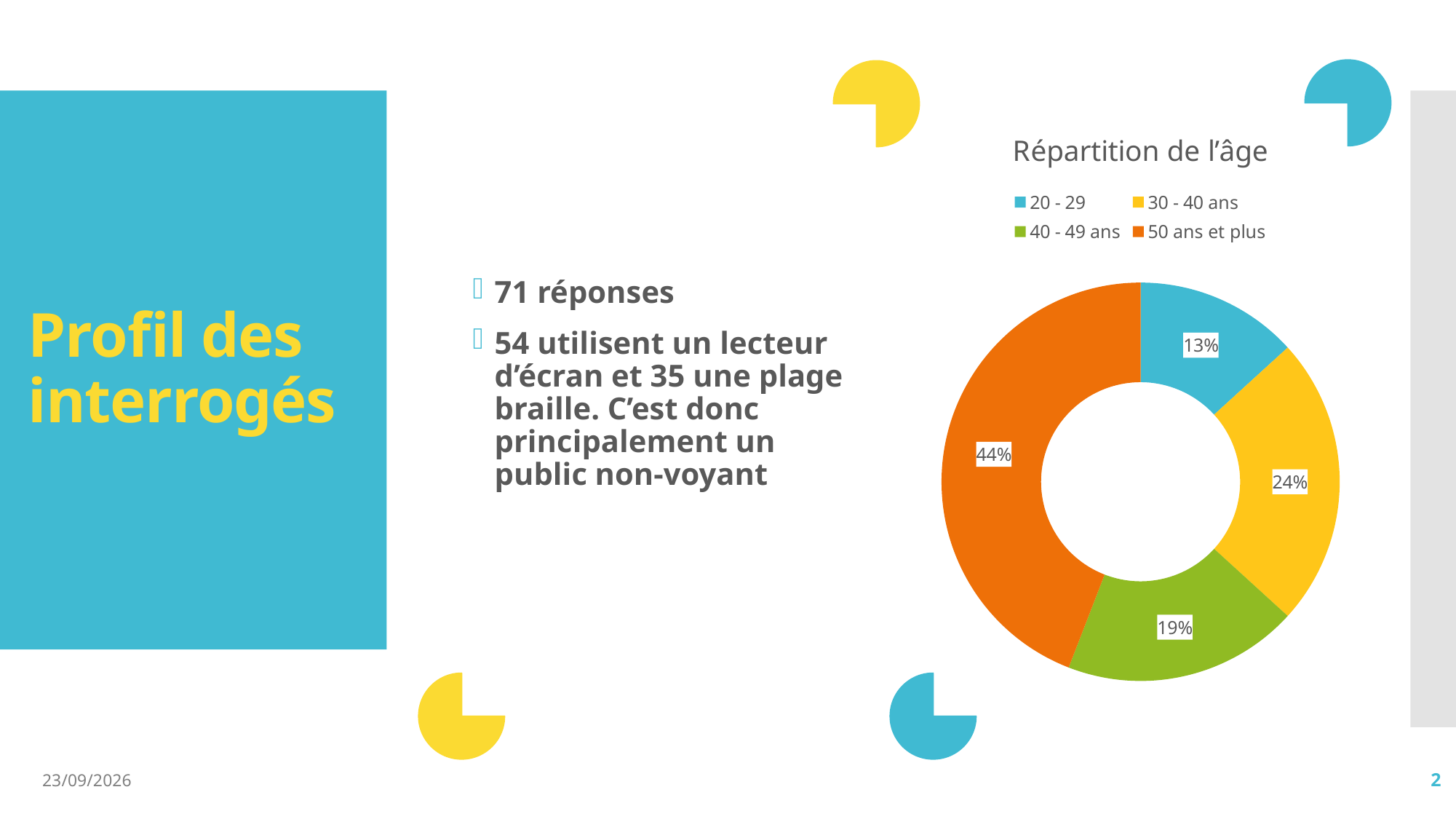
What share of respondents are in the 30 - 40 ans age group? 24% Which age group has the smallest share? 20 - 29 What is the title of the chart? Répartition de l'âge Which age group has the largest share? 50 ans et plus What share of respondents are in the 50 ans et plus age group? 44% What colour represents the 40 - 49 ans group? Green What is the difference in percentage points between the 50 ans et plus and 30 - 40 ans groups? 20 How many age groups are shown in the chart? 4 Which group has a larger share, 40 - 49 ans or 30 - 40 ans? 30 - 40 ans What share of respondents are in the 20 - 29 age group? 13% What kind of chart is shown on the slide? Doughnut chart What share of respondents are in the 40 - 49 ans age group? 19%